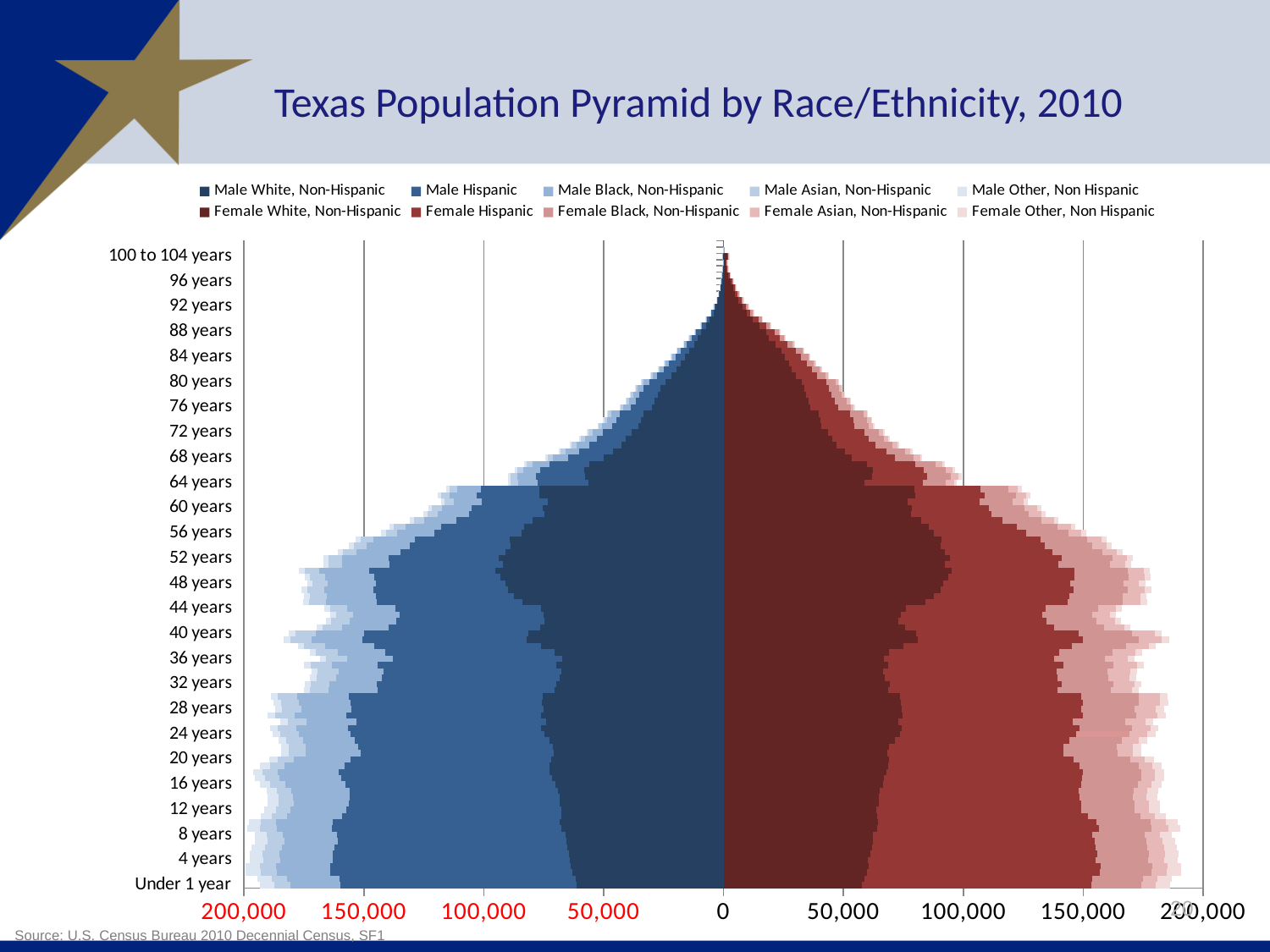
Which colour family is used for the male series in the legend? Blue At the Under 1 year age group, which male segment is larger: Male Hispanic or Male White, Non-Hispanic? Male Hispanic At the 64 years age group, which male segment is larger: Male White, Non-Hispanic or Male Hispanic? Male White, Non-Hispanic Is the total male population for the Under 1 year age group greater or less than 150,000? greater Is the total male population for the 64 years age group greater or less than 100,000? less What kind of chart is shown on the slide? Bar chart (population pyramid) Is the total female population for the 100 to 104 years age group greater or less than 50,000? less What is the title of the chart? Texas Population Pyramid by Race/Ethnicity, 2010 Do the total bar lengths generally increase or decrease as age increases from Under 1 year to 100 to 104 years? decrease How many series does the legend list? 10